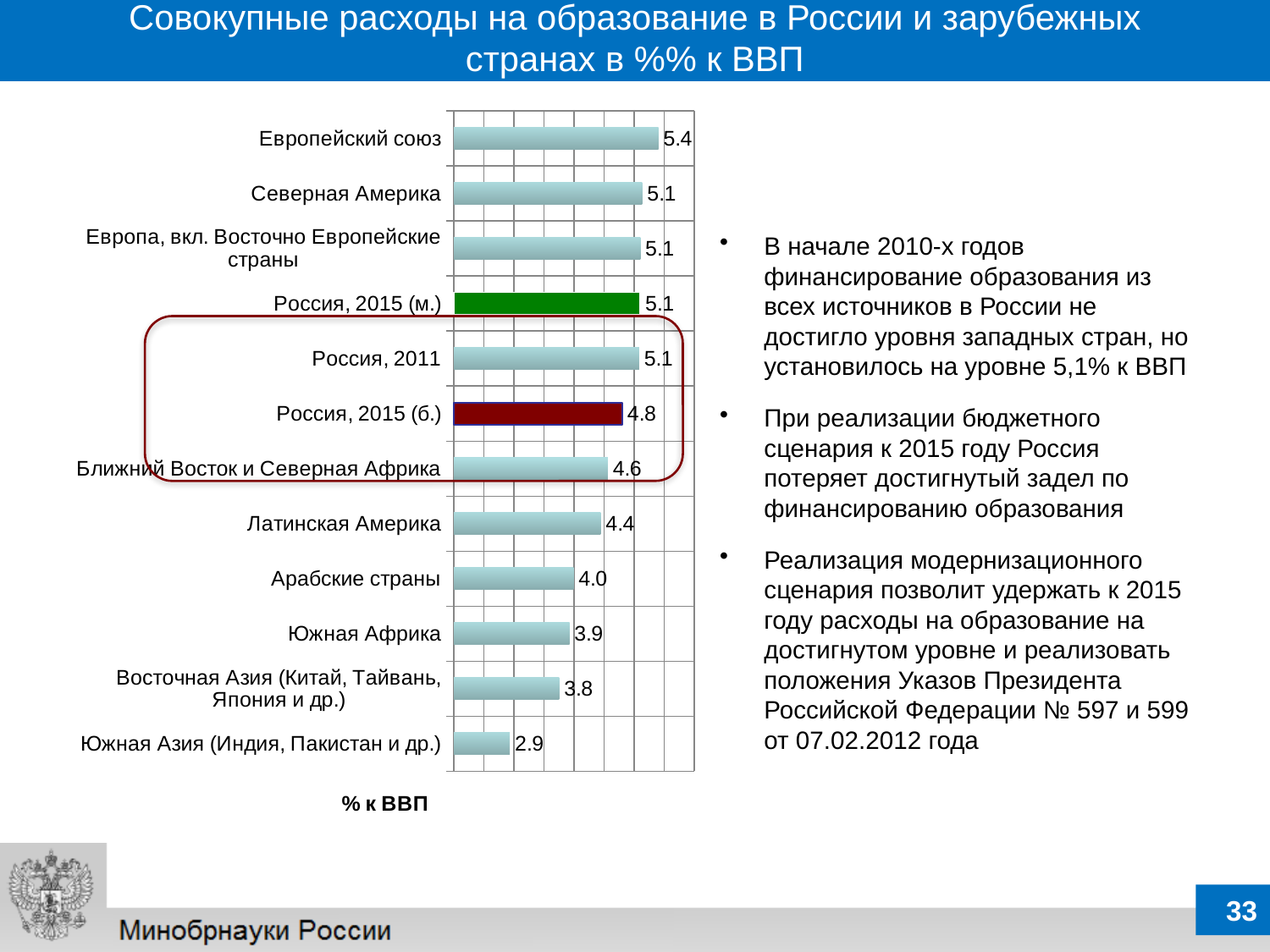
Which category has the lowest value? Южная Азия (Индия, Пакистан и др.) What is the axis label shown below the chart? % к ВВП Which is larger, the value for Латинская Америка or the value for Арабские страны? Латинская Америка What is the difference between the values for Россия, 2011 and Россия, 2015 (б.)? 0.3 What is the value for Европейский союз? 5.4 How many categories are shown in the chart? 12 What is the value for Россия, 2015 (б.)? 4.8 What is the value for Южная Азия (Индия, Пакистан и др.)? 2.9 Which category has the highest value? Европейский союз What kind of chart is shown on the slide? Bar chart What is the difference between the values for Европейский союз and Южная Азия (Индия, Пакистан и др.)? 2.5 What is the value for Ближний Восток и Северная Африка? 4.6